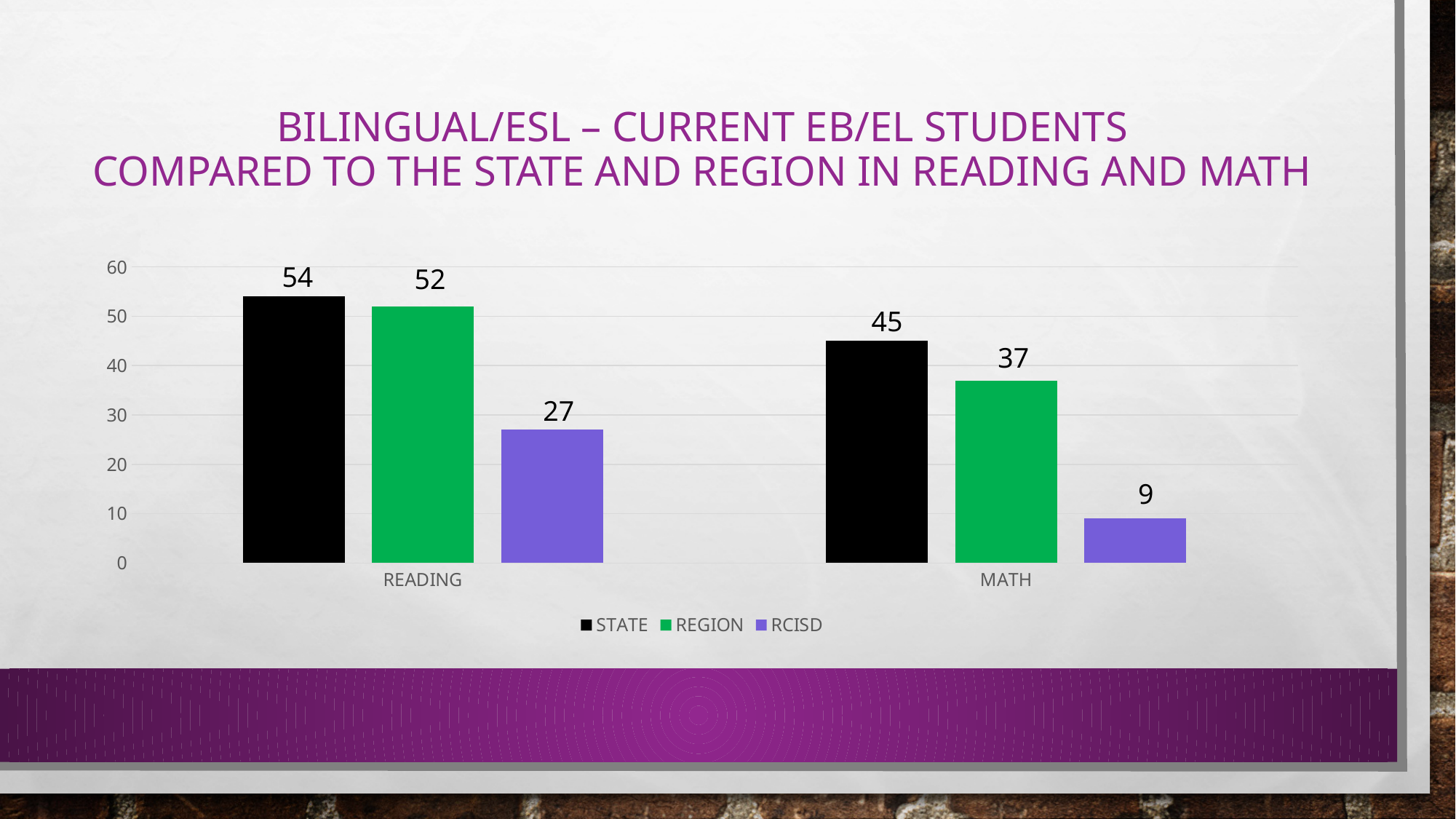
Which series has the lowest value for READING? RCISD Which is larger, the RCISD value for READING or the RCISD value for MATH? READING What is the difference between the STATE and RCISD values for READING? 27 What kind of chart is shown on the slide? bar chart What is the RCISD value for MATH? 9 Which series has the highest value for MATH? STATE What is the STATE value for READING? 54 What is the difference between the REGION values for READING and MATH? 15 Which colour represents the REGION series? green How many series does the legend list? 3 How many categories are shown on the x axis? 2 What is the REGION value for MATH? 37